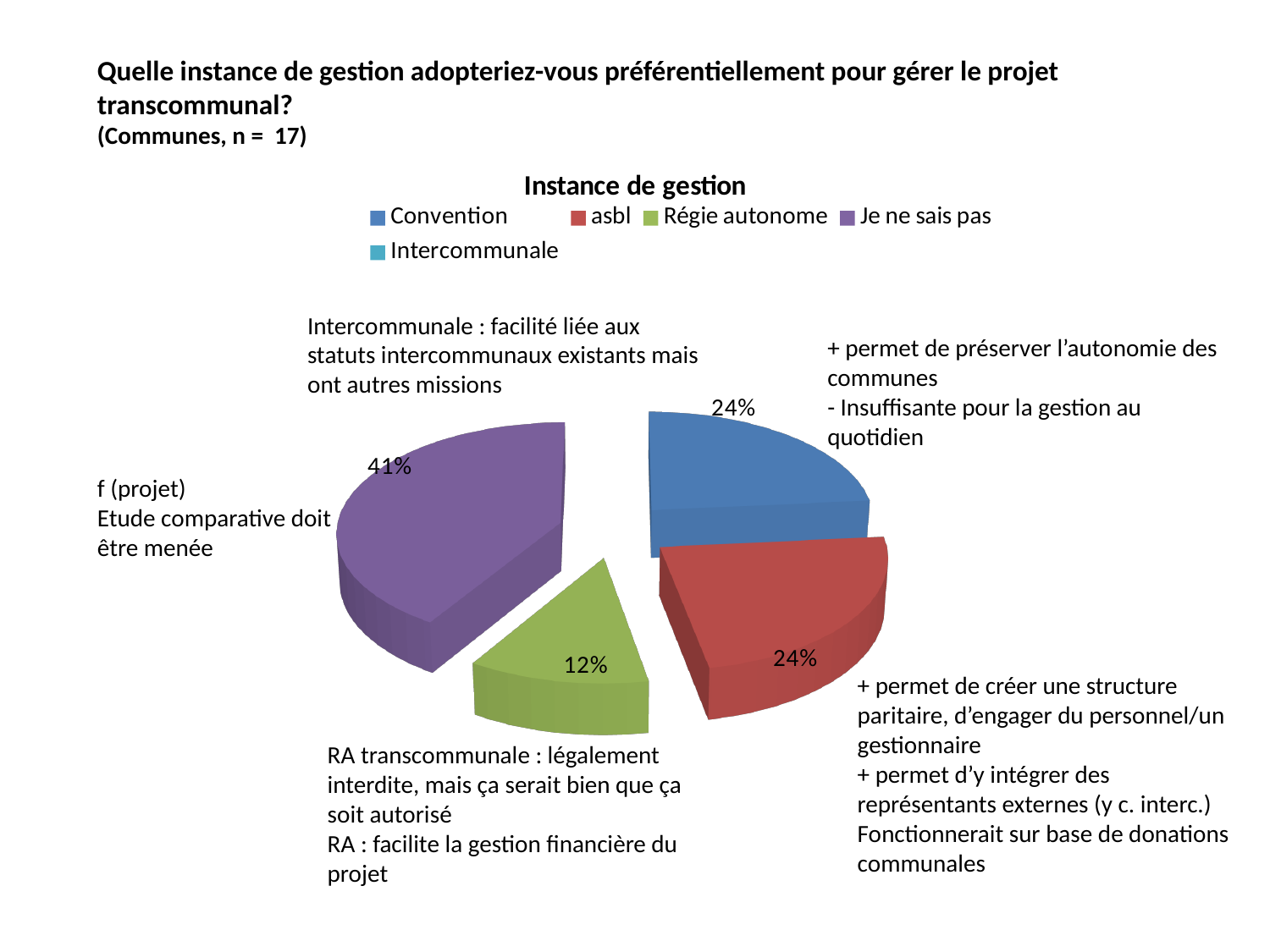
Which colour represents 'Je ne sais pas' in the chart? purple How many entries does the chart legend list? 5 Which category has the largest slice of the pie? Je ne sais pas What is the title of the chart? Instance de gestion What is the difference between the 'Je ne sais pas' share and the 'Régie autonome' share? 29% Which is larger, the 'Je ne sais pas' slice or the 'Convention' slice? Je ne sais pas What share of the pie does the 'asbl' slice represent? 24% What share of the pie does the 'Je ne sais pas' slice represent? 41% What type of chart is shown on the slide? pie chart What share of the pie does the 'Convention' slice represent? 24% Which category with a visible slice has the smallest share of the pie? Régie autonome